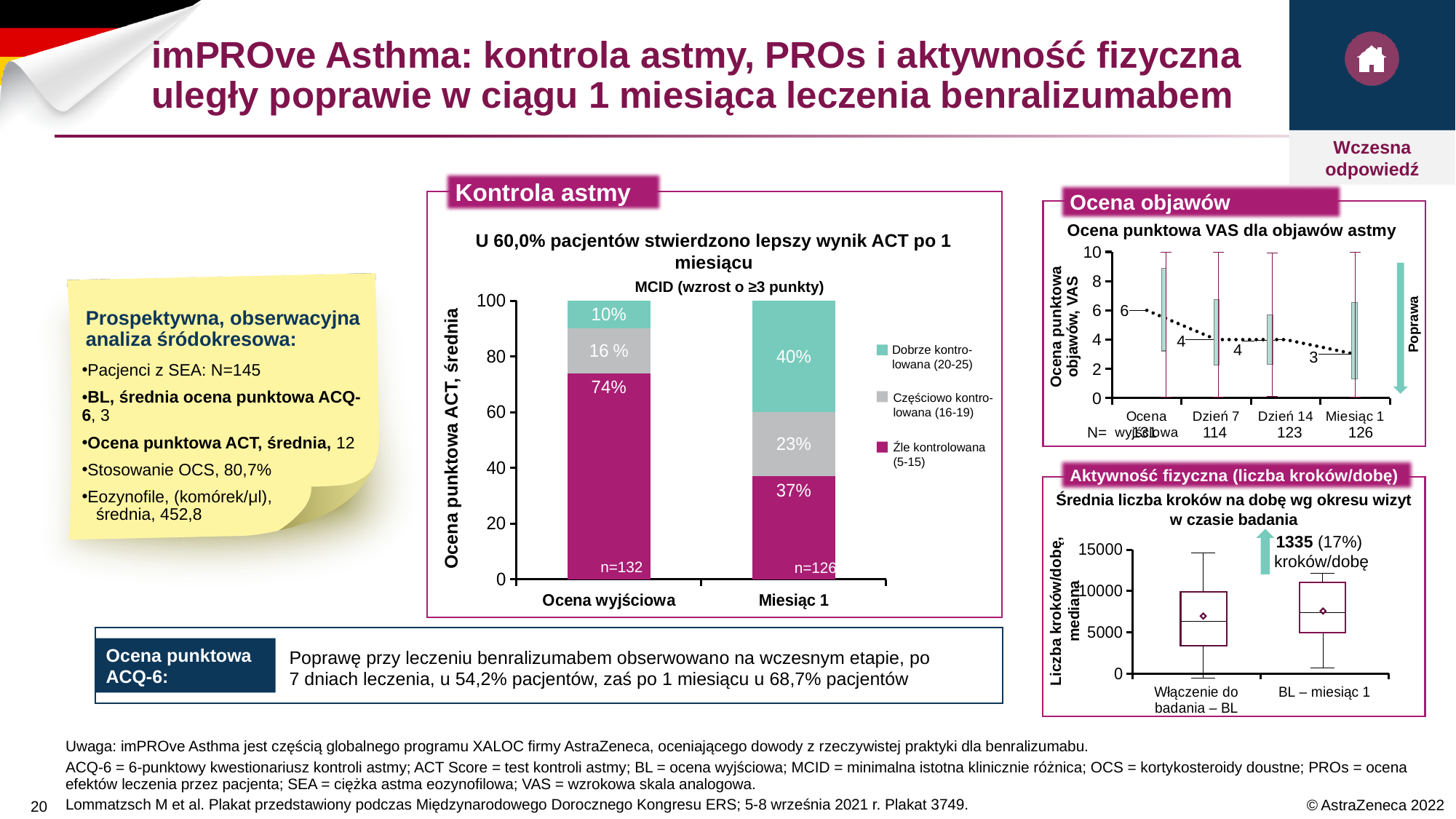
In the 'Kontrola astmy' chart, what percentage of patients were 'Częściowo kontrolowana' at Ocena wyjściowa? 16 % In the 'Ocena punktowa VAS dla objawów astmy' chart, what is the median VAS score at Miesiąc 1? 3 What kind of chart is the 'Kontrola astmy' chart? Stacked bar chart In the 'Kontrola astmy' chart, what is the n value shown for the Miesiąc 1 bar? n=126 How many series does the legend of the 'Kontrola astmy' chart list? 3 In the 'Ocena punktowa VAS dla objawów astmy' chart, do the median values rise or fall from Ocena wyjściowa to Miesiąc 1? Fall In the 'Kontrola astmy' chart, which is larger: the 'Dobrze kontrolowana' share at Ocena wyjściowa or at Miesiąc 1? Miesiąc 1 In the 'Kontrola astmy' chart, what percentage of patients were 'Źle kontrolowana' at Ocena wyjściowa? 74% In the 'Kontrola astmy' chart, what is the difference between the 'Źle kontrolowana' share at Ocena wyjściowa and at Miesiąc 1? 37% In the 'Ocena punktowa VAS dla objawów astmy' chart, what is the N value shown for Dzień 7? 114 In the 'Ocena punktowa VAS dla objawów astmy' chart, what is the median VAS score at Ocena wyjściowa? 6 In the 'Kontrola astmy' chart, what percentage of patients were 'Dobrze kontrolowana' at Miesiąc 1? 40%